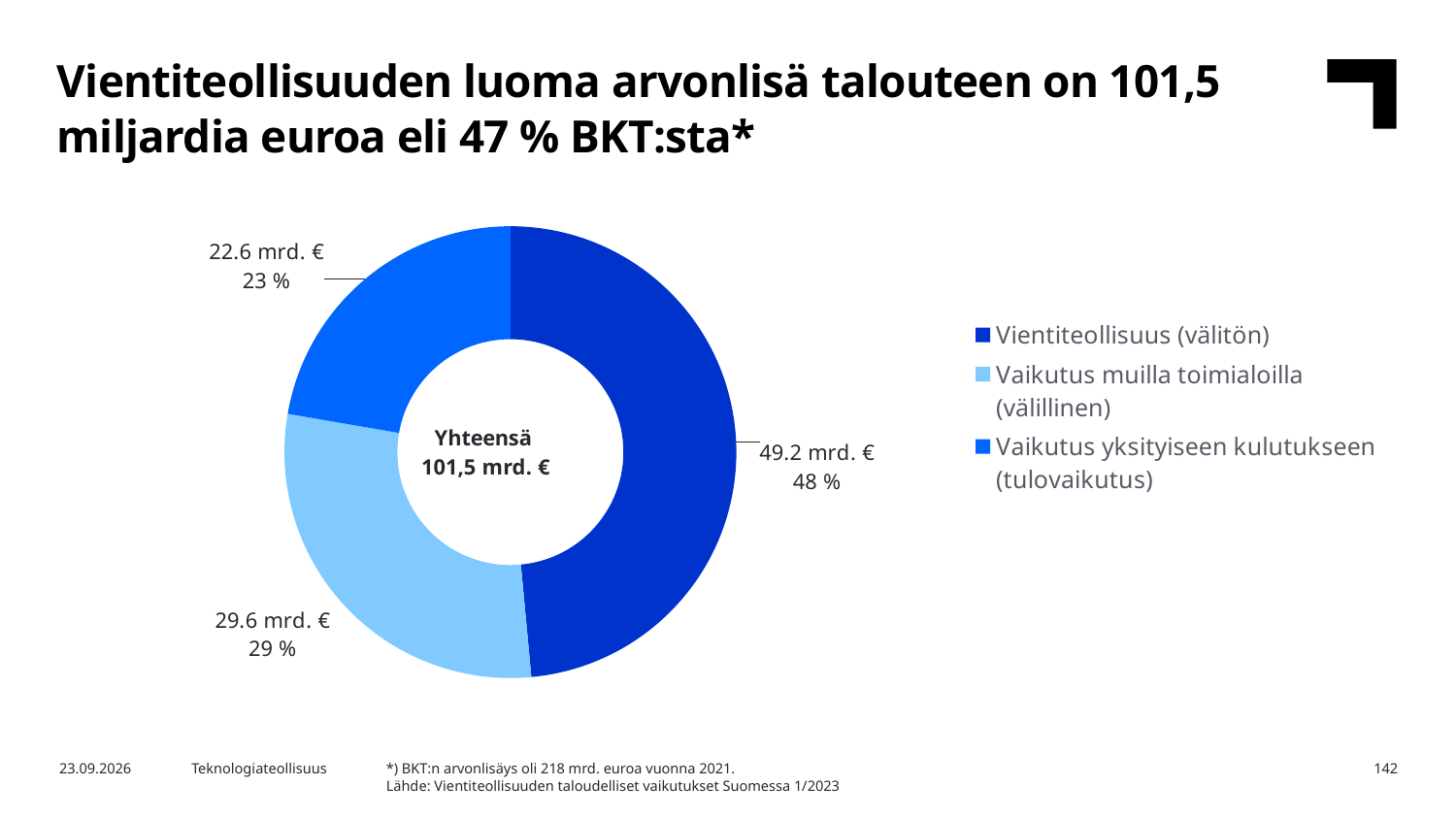
Which is larger, Vaikutus muilla toimialoilla (välillinen) or Vaikutus yksityiseen kulutukseen (tulovaikutus)? Vaikutus muilla toimialoilla (välillinen) What is the difference between the values for Vientiteollisuus (välitön) and Vaikutus muilla toimialoilla (välillinen)? 19.6 mrd. € What share of the total does Vaikutus yksityiseen kulutukseen (tulovaikutus) represent? 23 % What is the value for Vientiteollisuus (välitön)? 49.2 mrd. € What total is shown in the centre of the doughnut chart? Yhteensä 101,5 mrd. € How many categories does the chart show? 3 Which category has the largest slice? Vientiteollisuus (välitön) What is the value for Vaikutus muilla toimialoilla (välillinen)? 29.6 mrd. € What kind of chart is shown on the slide? Doughnut (pie) chart Which category has the smallest slice? Vaikutus yksityiseen kulutukseen (tulovaikutus) What share of the total does Vientiteollisuus (välitön) represent? 48 % What is the value for Vaikutus yksityiseen kulutukseen (tulovaikutus)? 22.6 mrd. €